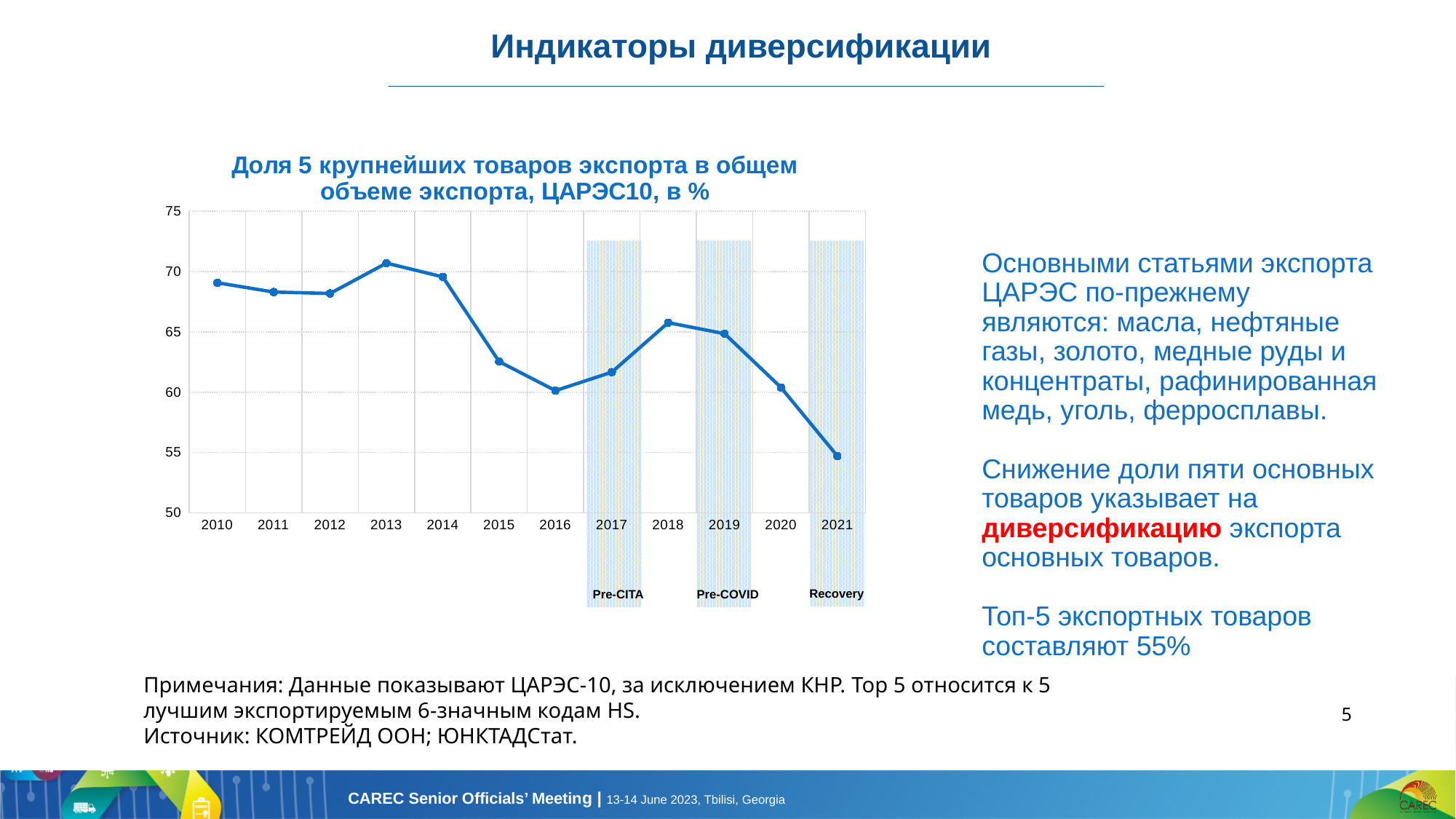
What kind of chart is shown on the slide? line chart Which year has the larger value, 2016 or 2018? 2018 Is the value for 2010 greater or less than 70? less In which year is the share of the 5 largest export goods the lowest? 2021 In which year is the share of the 5 largest export goods the highest? 2013 How many years are plotted on the x axis of the chart? 12 Is the value for 2013 greater or less than 70? greater Is the value for 2015 greater or less than 60? greater Overall, does the share of the 5 largest export goods rise or fall from 2010 to 2021? fall Which year has the larger value, 2010 or 2021? 2010 Which year on the chart is marked with the shaded label "Recovery"? 2021